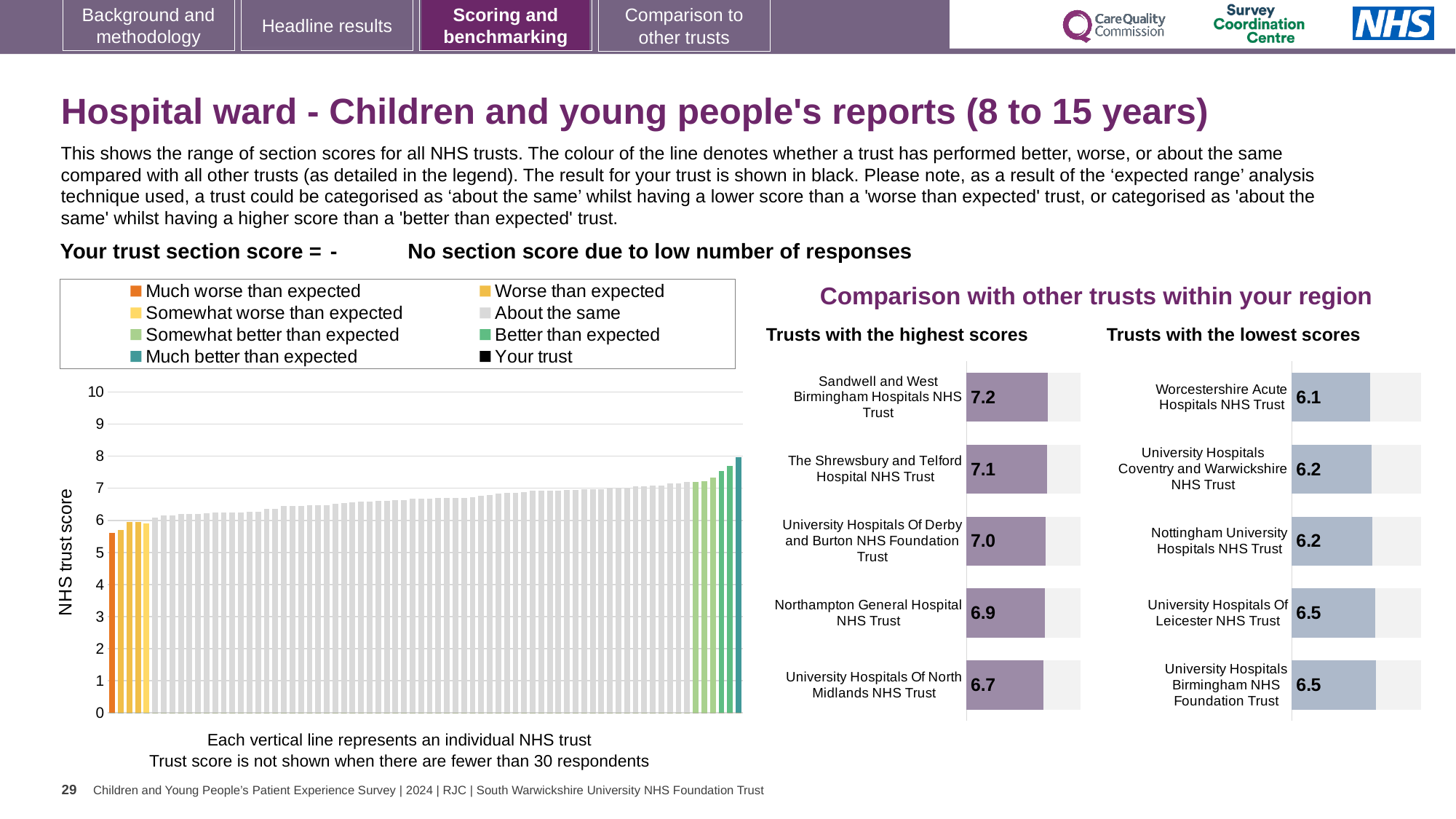
In the 'Trusts with the highest scores' chart, which trust has the lowest score? University Hospitals Of North Midlands NHS Trust What kind of chart is the left-hand chart showing NHS trust scores? Bar chart In the 'Trusts with the lowest scores' chart, which has the larger score: University Hospitals Of Leicester NHS Trust or Nottingham University Hospitals NHS Trust? University Hospitals Of Leicester NHS Trust In the 'Trusts with the highest scores' chart, what is the difference between the scores of Sandwell and West Birmingham Hospitals NHS Trust and University Hospitals Of North Midlands NHS Trust? 0.5 In the 'Trusts with the lowest scores' chart, what is the score for Worcestershire Acute Hospitals NHS Trust? 6.1 In the 'Trusts with the highest scores' chart, which trust has the highest score? Sandwell and West Birmingham Hospitals NHS Trust In the left-hand NHS trust score chart, is the tallest bar greater or less than 7? greater How many trusts are shown in the 'Trusts with the highest scores' chart? 5 In the 'Trusts with the lowest scores' chart, which trust has the lowest score? Worcestershire Acute Hospitals NHS Trust How many entries does the legend of the left-hand NHS trust score chart list? 8 In the 'Trusts with the highest scores' chart, what is the score for Northampton General Hospital NHS Trust? 6.9 In the 'Trusts with the highest scores' chart, what is the score for Sandwell and West Birmingham Hospitals NHS Trust? 7.2